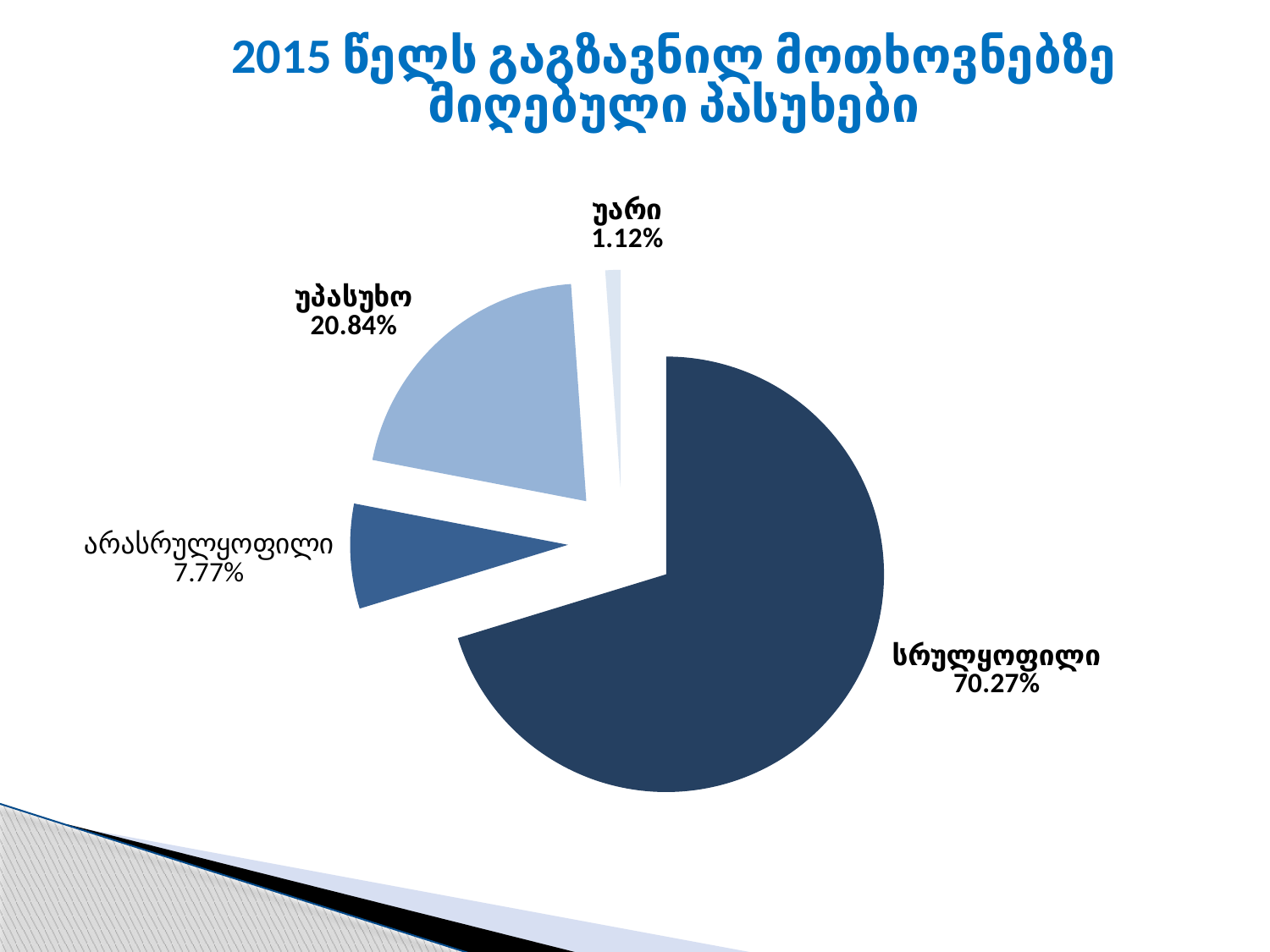
How many slices does the pie chart have? 4 What is the value for არასრულყოფილი? 7.77% What is the value for სრულყოფილი? 70.27% Which category has the smallest share of the pie? უარი What is the value for უპასუხო? 20.84% What is the value for უარი? 1.12% What is the difference between the shares of სრულყოფილი and უპასუხო? 49.43% Which is larger, the share of არასრულყოფილი or the share of უარი? არასრულყოფილი What kind of chart is shown on the slide? pie chart What is the combined share of უპასუხო and არასრულყოფილი? 28.61% Which category has the largest share of the pie? სრულყოფილი What is the title of the chart on the slide? 2015 წელს გაგზავნილ მოთხოვნებზე მიღებული პასუხები